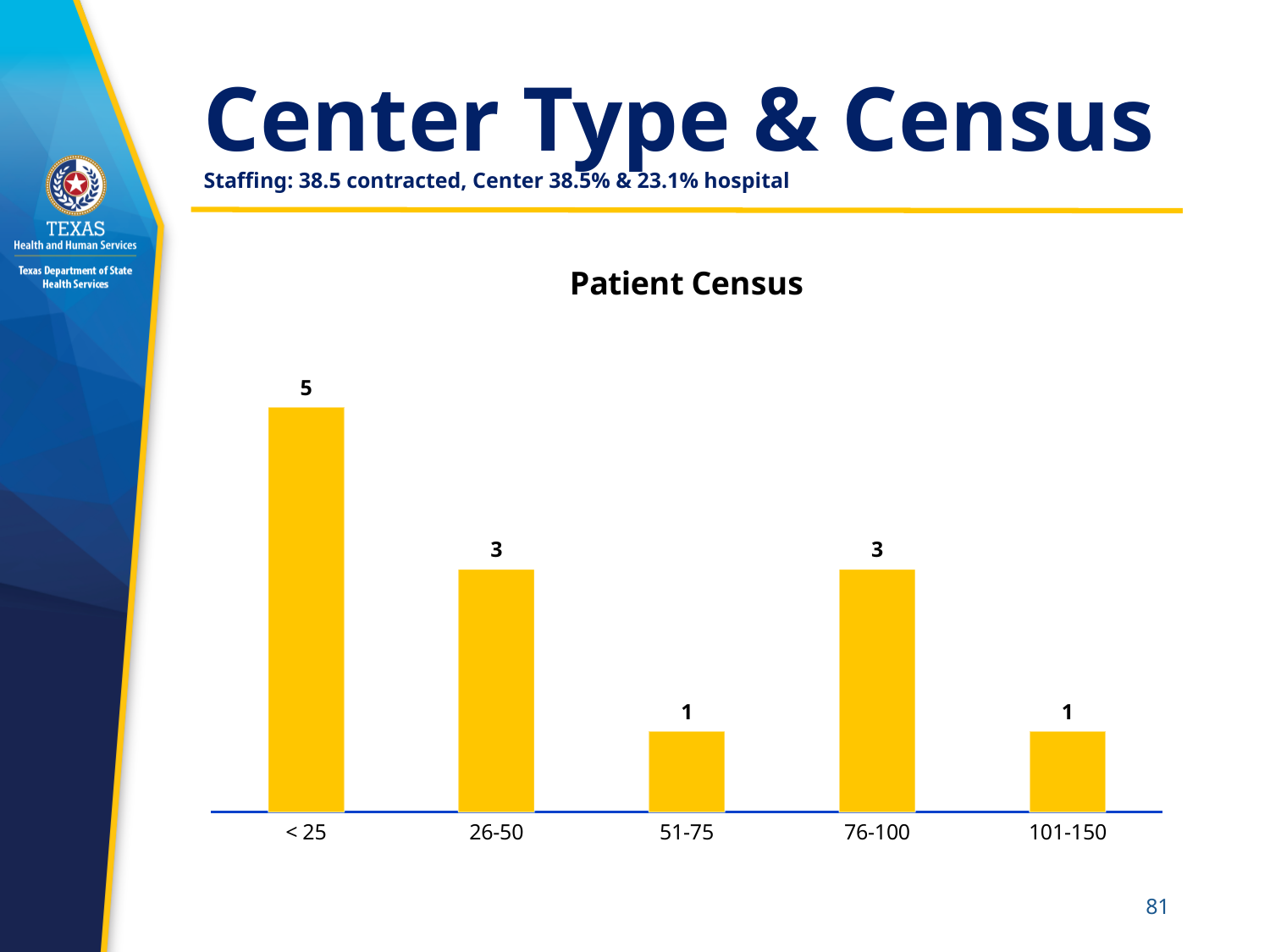
What is the value for the 51-75 category? 1 What is the title of the chart on the slide? Patient Census Which category has the highest value in the Patient Census chart? < 25 What is the value for the 101-150 category? 1 What is the difference between the values for < 25 and 26-50? 2 Which is larger, the value for 26-50 or the value for 51-75? 26-50 What is the difference between the values for 76-100 and 101-150? 2 How many categories are shown on the x axis of the Patient Census chart? 5 What is the value for the 26-50 category? 3 What is the value for the 76-100 category? 3 What kind of chart is the Patient Census chart? bar chart What is the value for the < 25 category in the Patient Census chart? 5